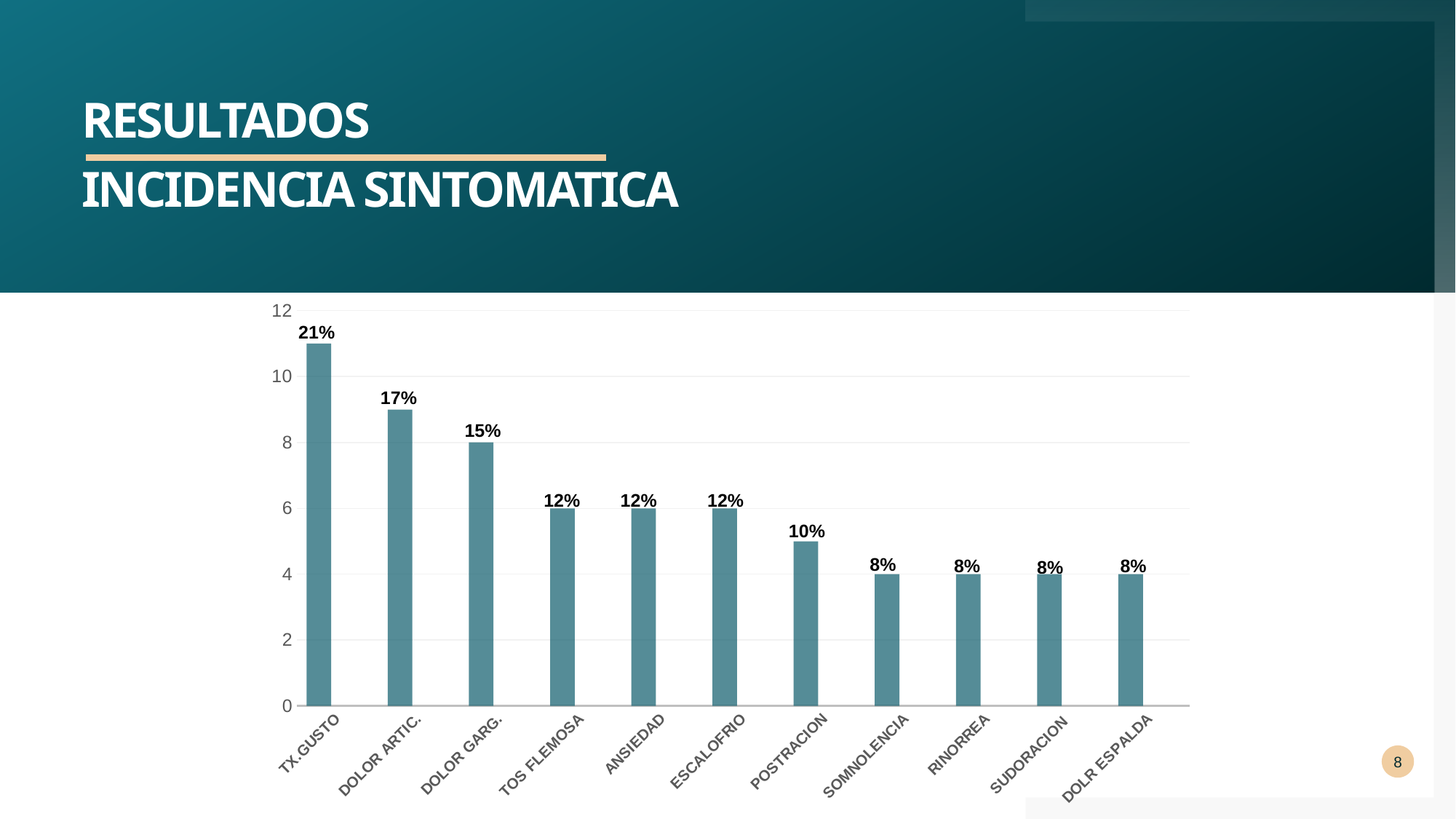
What kind of chart is shown on the slide? Bar chart What is the difference between the data labels for TX.GUSTO and DOLOR GARG.? 6% What is the data label shown for TX.GUSTO? 21% How many categories are shown on the x axis? 11 Which category has the highest bar? TX.GUSTO How many categories share the lowest data label of 8%? 4 Which is larger, the value for DOLOR ARTIC. or the value for TOS FLEMOSA? DOLOR ARTIC. Is the bar for DOLOR GARG. greater or less than 6 on the vertical axis? greater What is the data label shown for DOLOR ARTIC.? 17% What is the data label shown for RINORREA? 8% Do the bar values rise or fall from left to right along the x axis? Fall What is the data label shown for POSTRACION? 10%